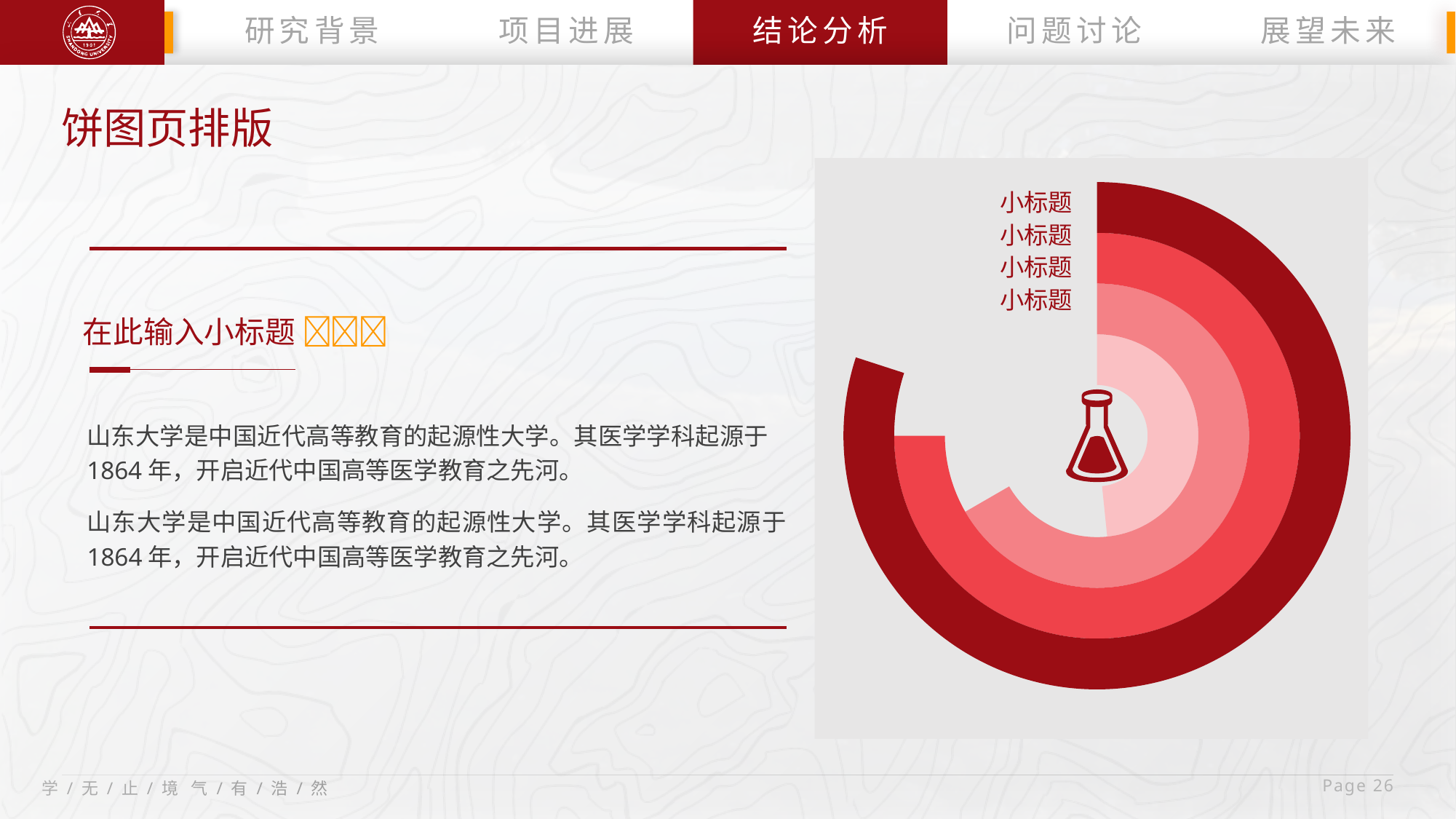
How many arc segments does the radial chart on the right contain? 4 Is the outermost arc of the chart longer or shorter than the second arc from the outside? Longer Which arc of the chart is the shortest, the outermost or the innermost? The innermost Which arc of the chart is the longest, the outermost or the innermost? The outermost What colour family are the segments of the chart drawn in? Shades of red